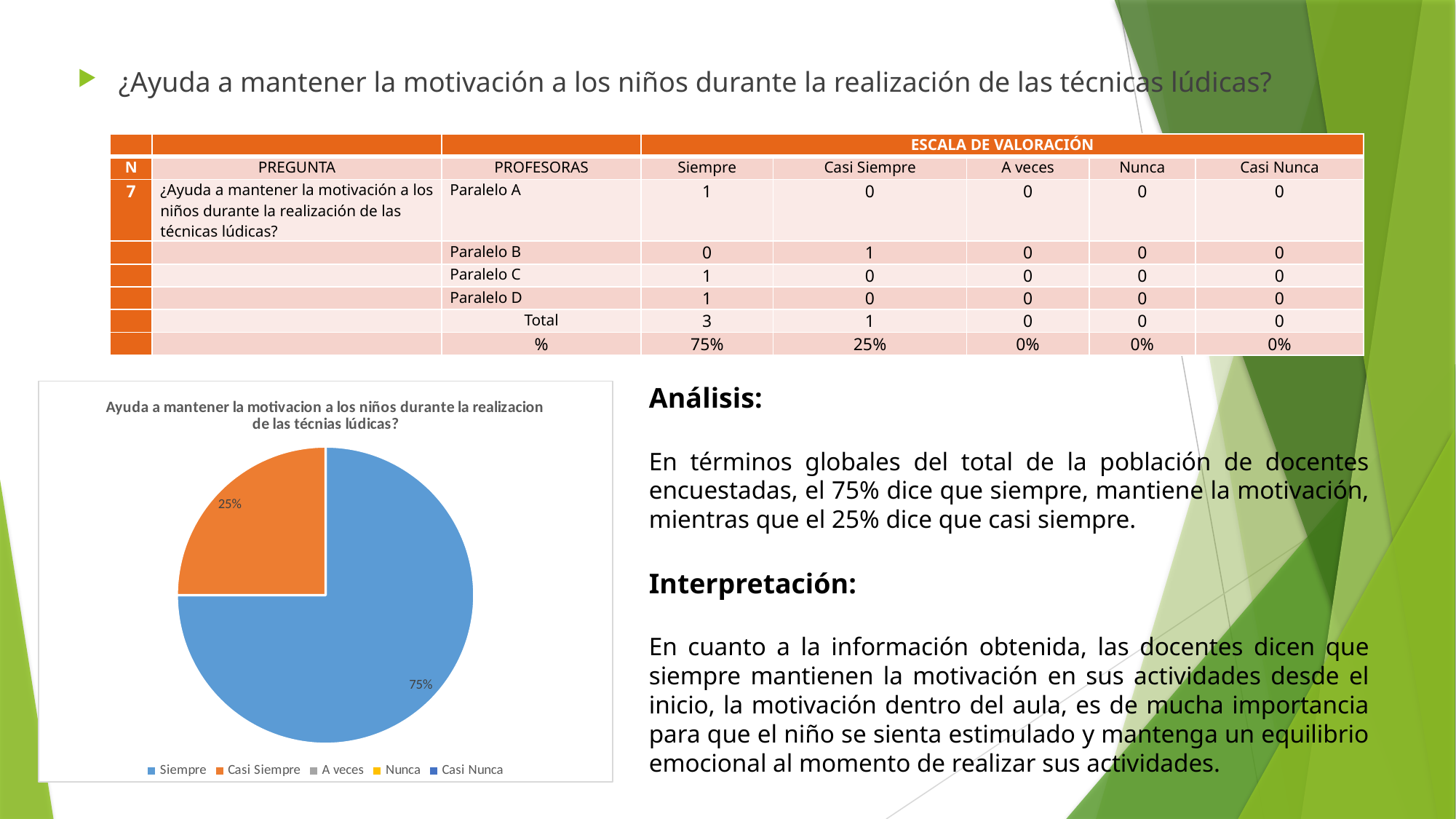
What share of the pie does the Siempre slice represent? 75% What colour is the Casi Siempre slice in the pie chart? orange Which of the two visible slices is larger, Siempre or Casi Siempre? Siempre What colour is the Siempre slice in the pie chart? blue What is the total of the two labelled slices in the pie chart? 100% What kind of chart is shown on the slide? pie chart Which category has the largest slice in the pie chart? Siempre How many entries does the legend of the pie chart list? 5 What share of the pie does the Casi Siempre slice represent? 25% How many slices are visible in the pie chart? 2 What is the difference in percentage points between the Siempre slice and the Casi Siempre slice? 50%